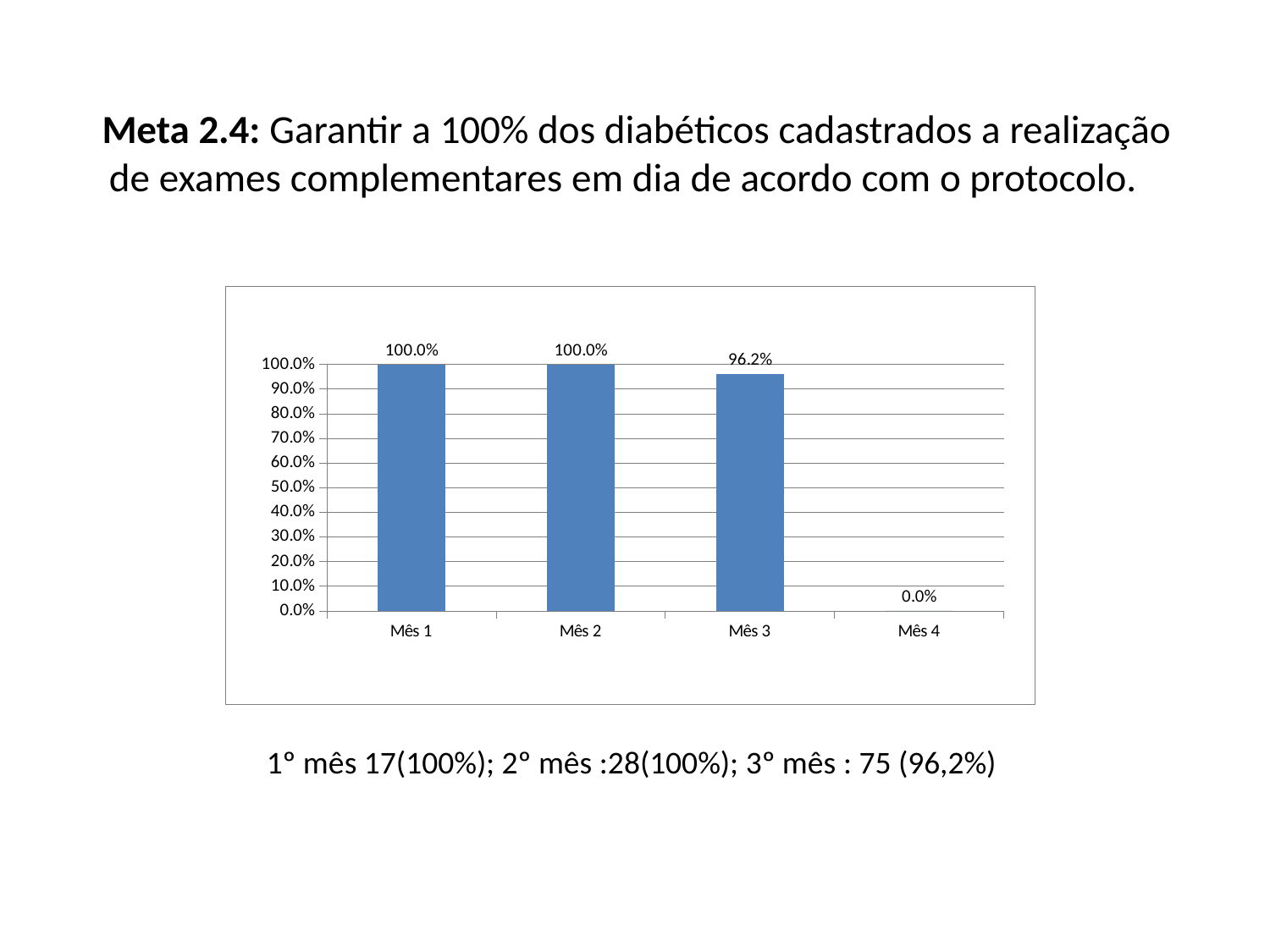
Which is larger, the value for Mês 1 or the value for Mês 3? Mês 1 What kind of chart is shown on the slide? bar chart What is the difference between the values for Mês 1 and Mês 2? 0.0% What is the value for Mês 3? 96.2% Is the value for Mês 3 greater or less than 90.0%? greater What is the value for Mês 1? 100.0% What is the value for Mês 4? 0.0% What colour are the bars in the chart? blue Do the values rise or fall from Mês 2 to Mês 4? fall What is the difference between the values for Mês 2 and Mês 3? 3.8% How many categories are shown on the x axis? 4 Which category has the lowest value? Mês 4